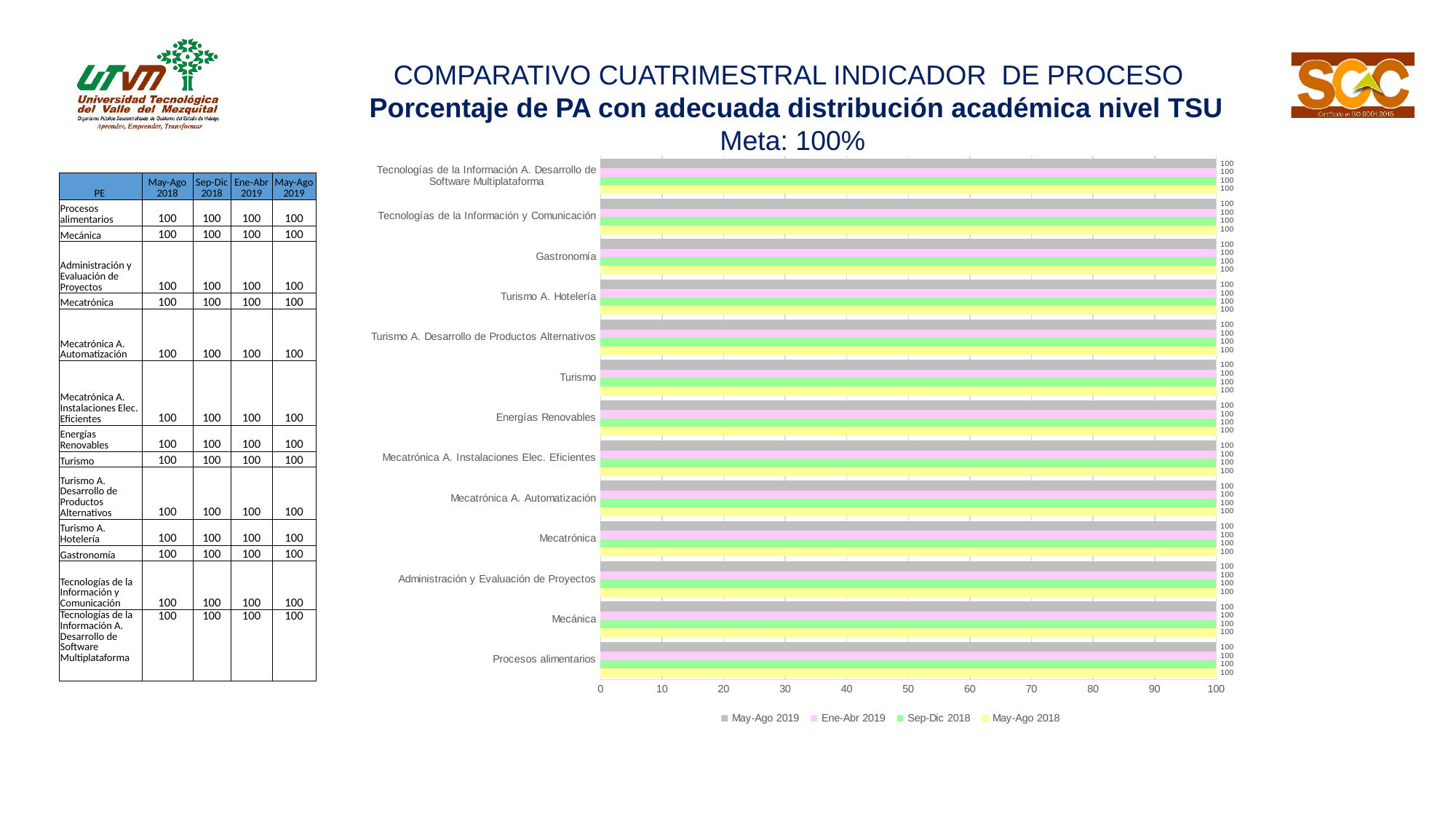
What is the value for Procesos alimentarios in the May-Ago 2018 series? 100 What is the target (Meta) stated in the chart title? 100% What is the value for Gastronomía in the May-Ago 2019 series? 100 Is the value for Mecatrónica in the Ene-Abr 2019 series greater or less than 90? greater What is the value for Turismo A. Hotelería in the Ene-Abr 2019 series? 100 How many series does the chart legend list? 4 What is the value for Administración y Evaluación de Proyectos in the Sep-Dic 2018 series? 100 Which series is shown in the legend with a yellow colour? May-Ago 2018 How many categories (programs) are plotted on the chart? 13 What is the difference between the May-Ago 2019 value and the May-Ago 2018 value for Energías Renovables? 0 What is the value for Mecánica in the Sep-Dic 2018 series? 100 What kind of chart is shown on the slide? bar chart